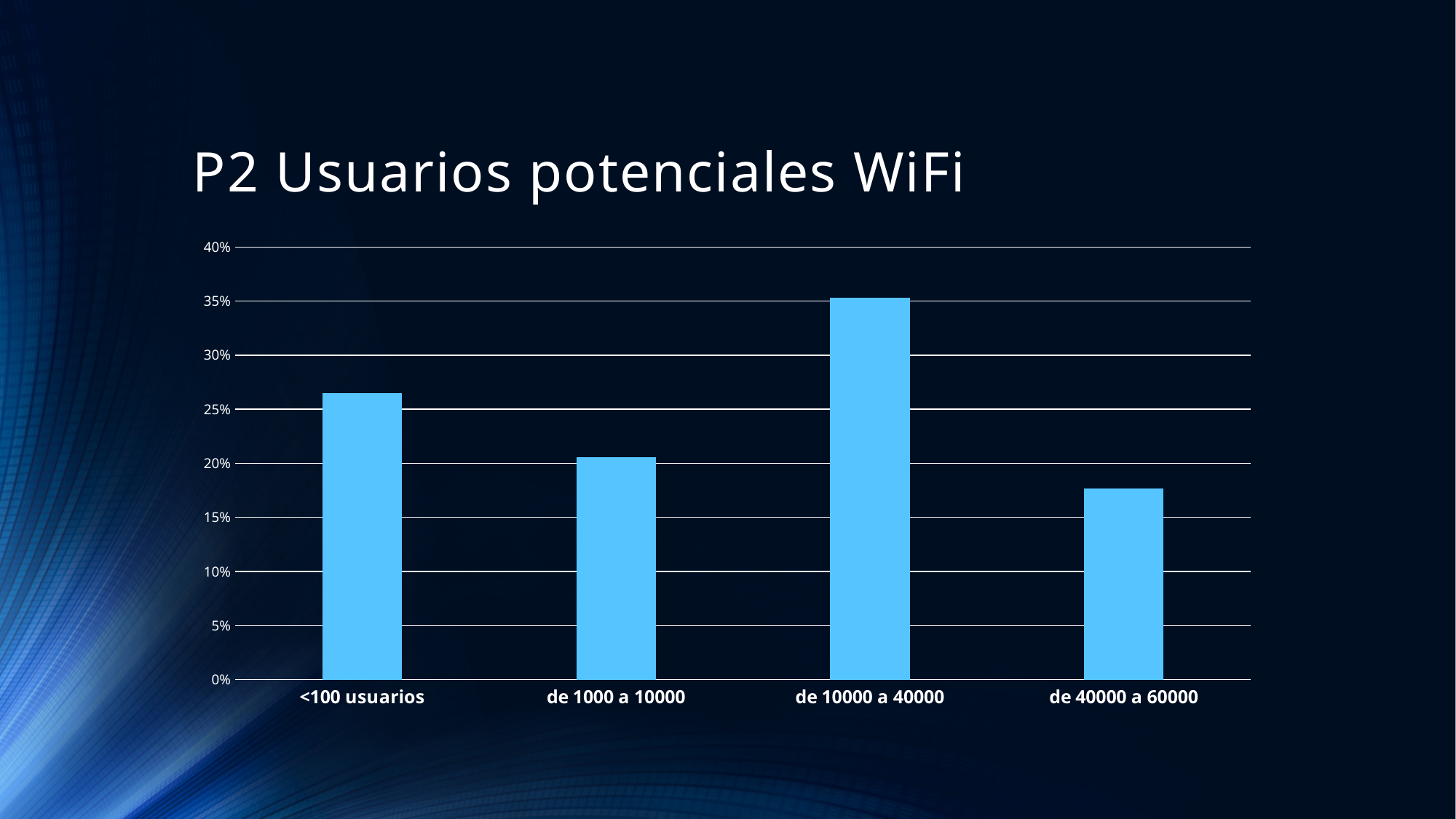
Which category has the highest value? de 10000 a 40000 Which is larger, the value for <100 usuarios or the value for de 1000 a 10000? <100 usuarios What is the title of the slide? P2 Usuarios potenciales WiFi Is the value for de 10000 a 40000 greater or less than 30%? greater How many categories are shown on the x axis of the chart? 4 Which is larger, the value for de 10000 a 40000 or the value for de 40000 a 60000? de 10000 a 40000 Is the value for de 40000 a 60000 greater or less than 20%? less Is the value for <100 usuarios greater or less than 25%? greater What kind of chart is shown on the slide? bar chart Which category has the lowest value? de 40000 a 60000 What is the highest value shown on the y axis? 40%